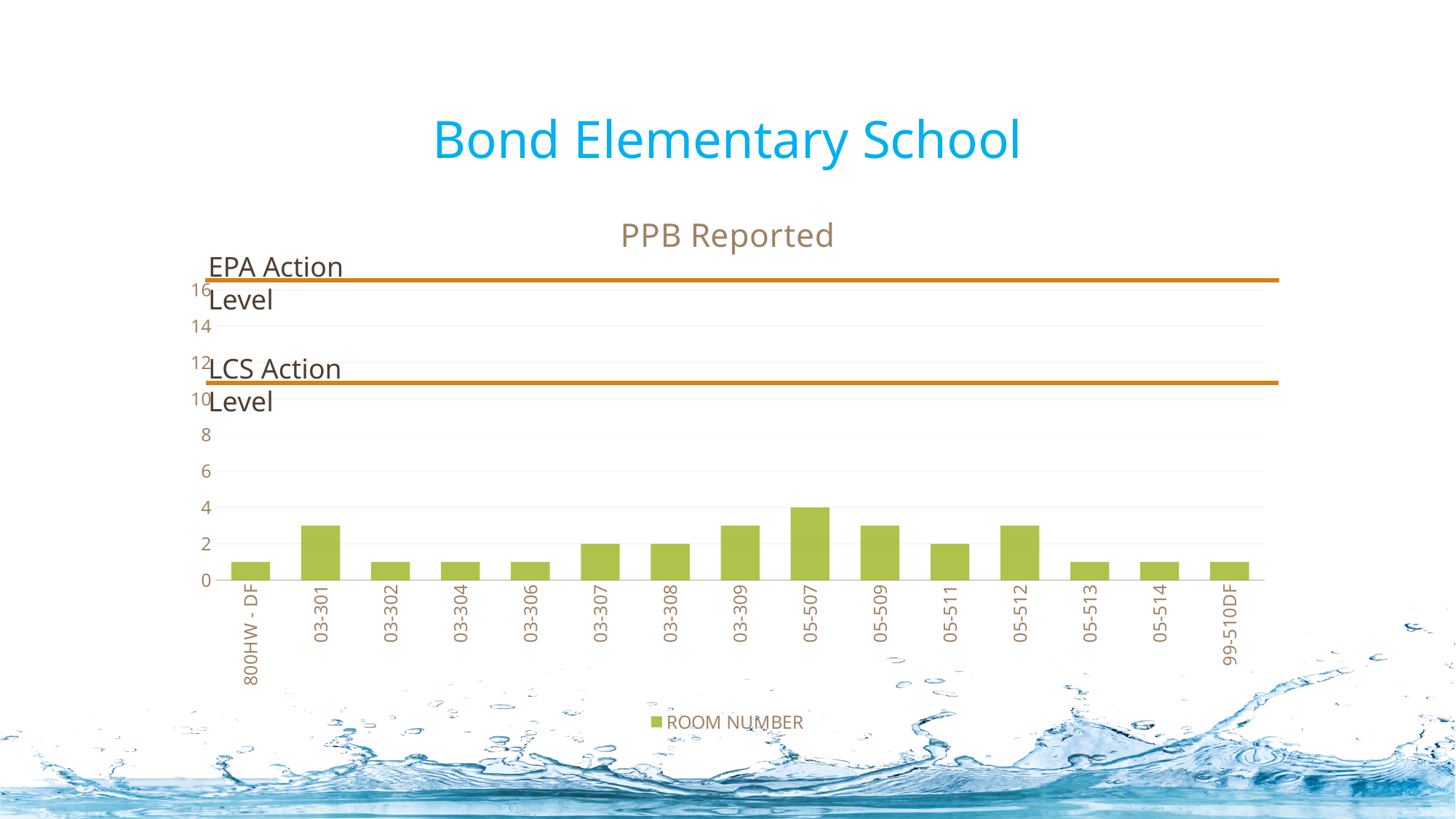
Which has a larger value, room 03-301 or room 03-302? 03-301 What type of chart is shown on the slide? bar chart How many room categories are plotted on the x axis? 15 What is the PPB reported value for room 03-307? 2 What is the title of the chart? PPB Reported What is the PPB reported value for room 05-511? 2 What is the difference between the values for room 05-507 and room 03-308? 2 Is the value for room 03-301 greater or less than 2? greater What are the two horizontal reference lines on the chart labelled? EPA Action Level and LCS Action Level What is the PPB reported value for room 05-507? 4 Which room has the highest PPB reported value? 05-507 How many series does the legend list? 1